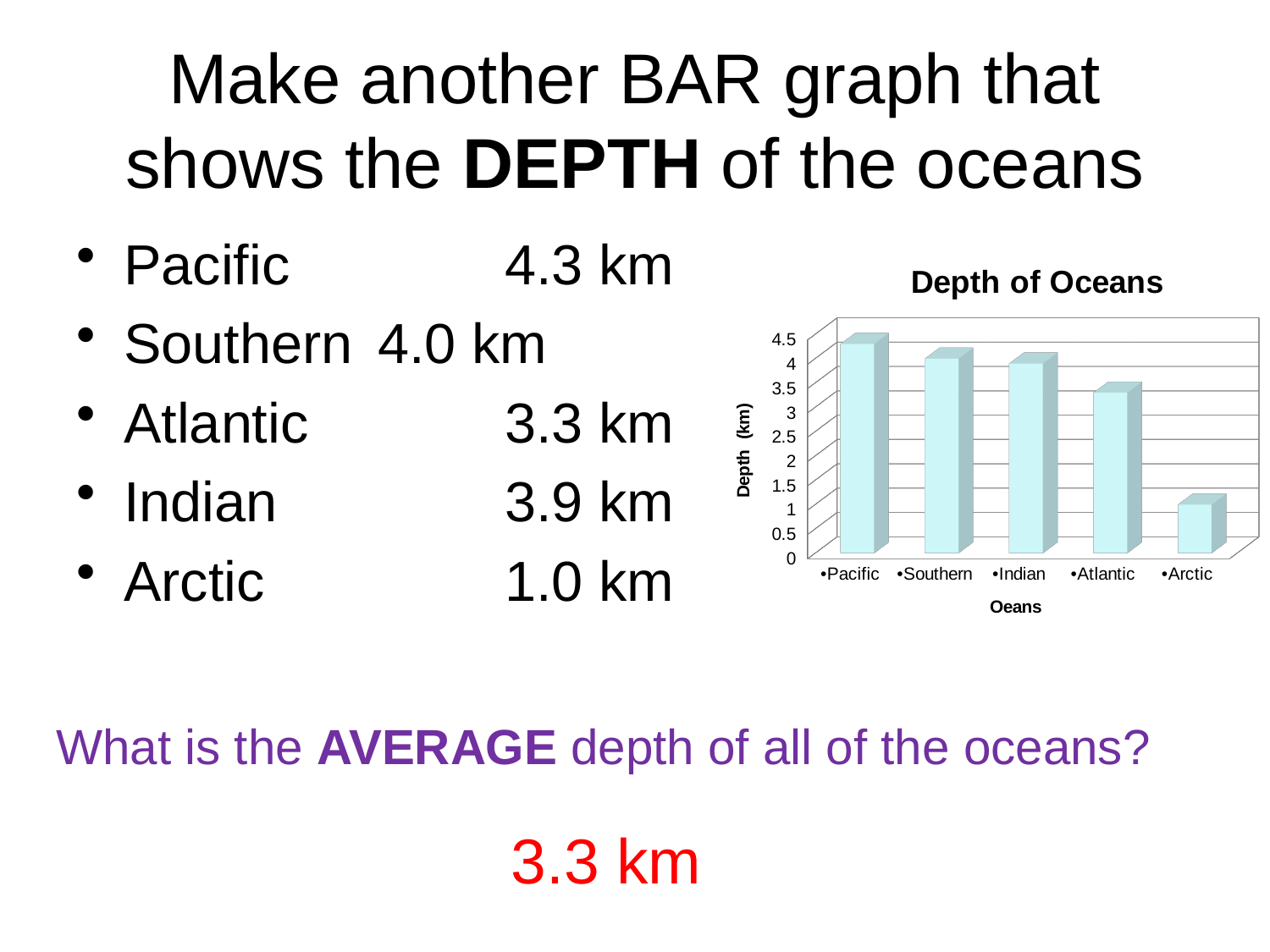
What is the depth shown for the Pacific ocean? 4.3 km Which ocean has the smallest depth in the chart? Arctic What kind of chart is shown on the slide? bar chart What is the difference in depth between the Pacific and the Arctic? 3.3 km Is the value for Indian greater or less than 3.5? greater What is the depth shown for the Arctic ocean? 1.0 km Which is deeper according to the chart, Atlantic or Arctic? Atlantic What is the depth shown for the Southern ocean? 4.0 km How many oceans are plotted in the chart? 5 What is the title of the chart? Depth of Oceans Is the value for Atlantic greater or less than 3.5? less Which ocean has the greatest depth in the chart? Pacific